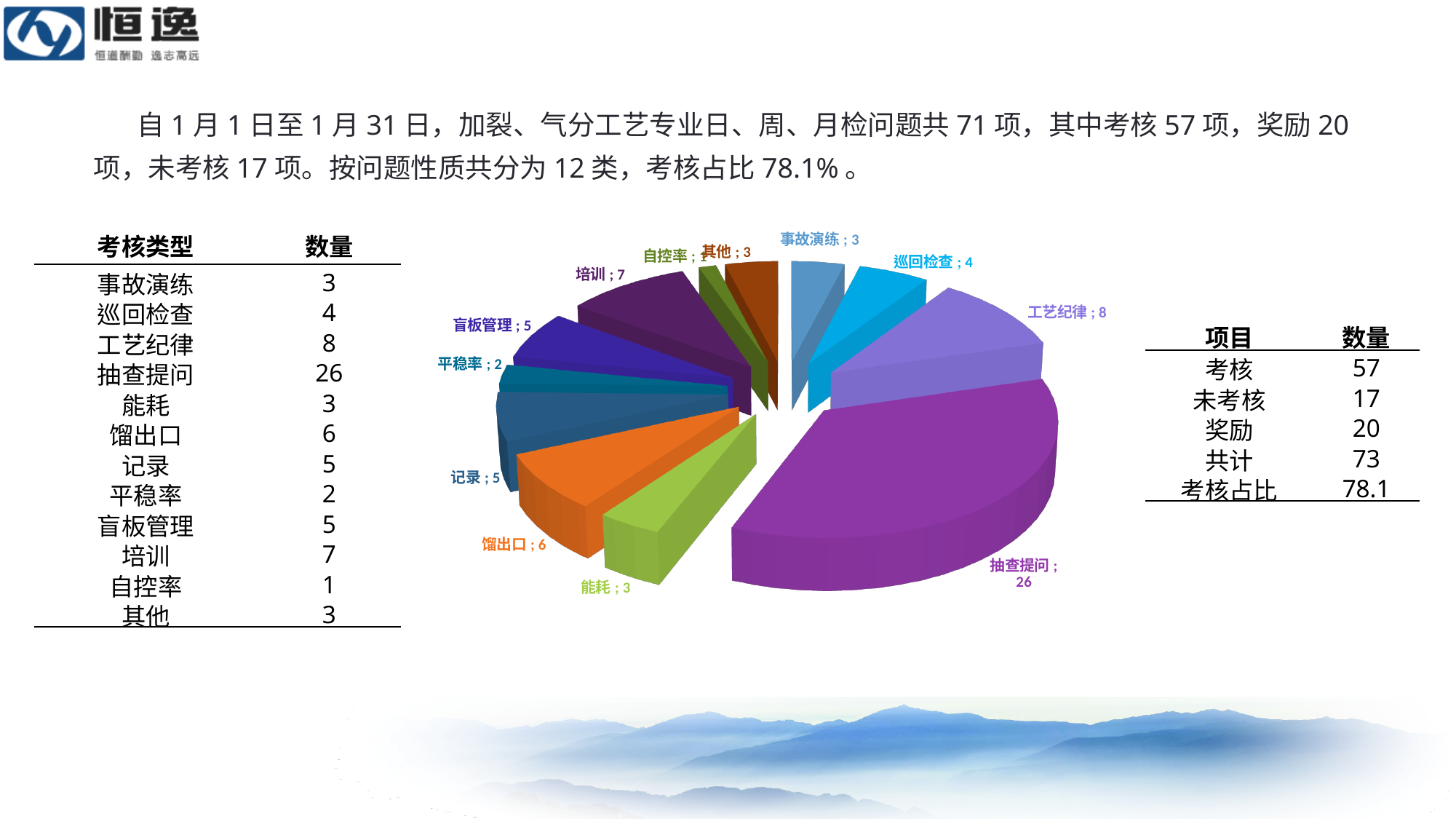
Which is larger in the pie chart, 馏出口 or 记录? 馏出口 What colour is the 抽查提问 slice in the pie chart? purple Which is larger in the pie chart, 事故演练 or 巡回检查? 巡回检查 What is the value for 工艺纪律 in the pie chart? 8 How many slices does the pie chart have? 12 What is the value for 巡回检查 in the pie chart? 4 What is the difference between the values for 培训 and 盲板管理 in the pie chart? 2 What kind of chart is shown on the slide? pie chart Which category has the largest slice in the pie chart? 抽查提问 What is the value for 抽查提问 in the pie chart? 26 What is the difference between the values for 抽查提问 and 工艺纪律 in the pie chart? 18 What is the value for 培训 in the pie chart? 7